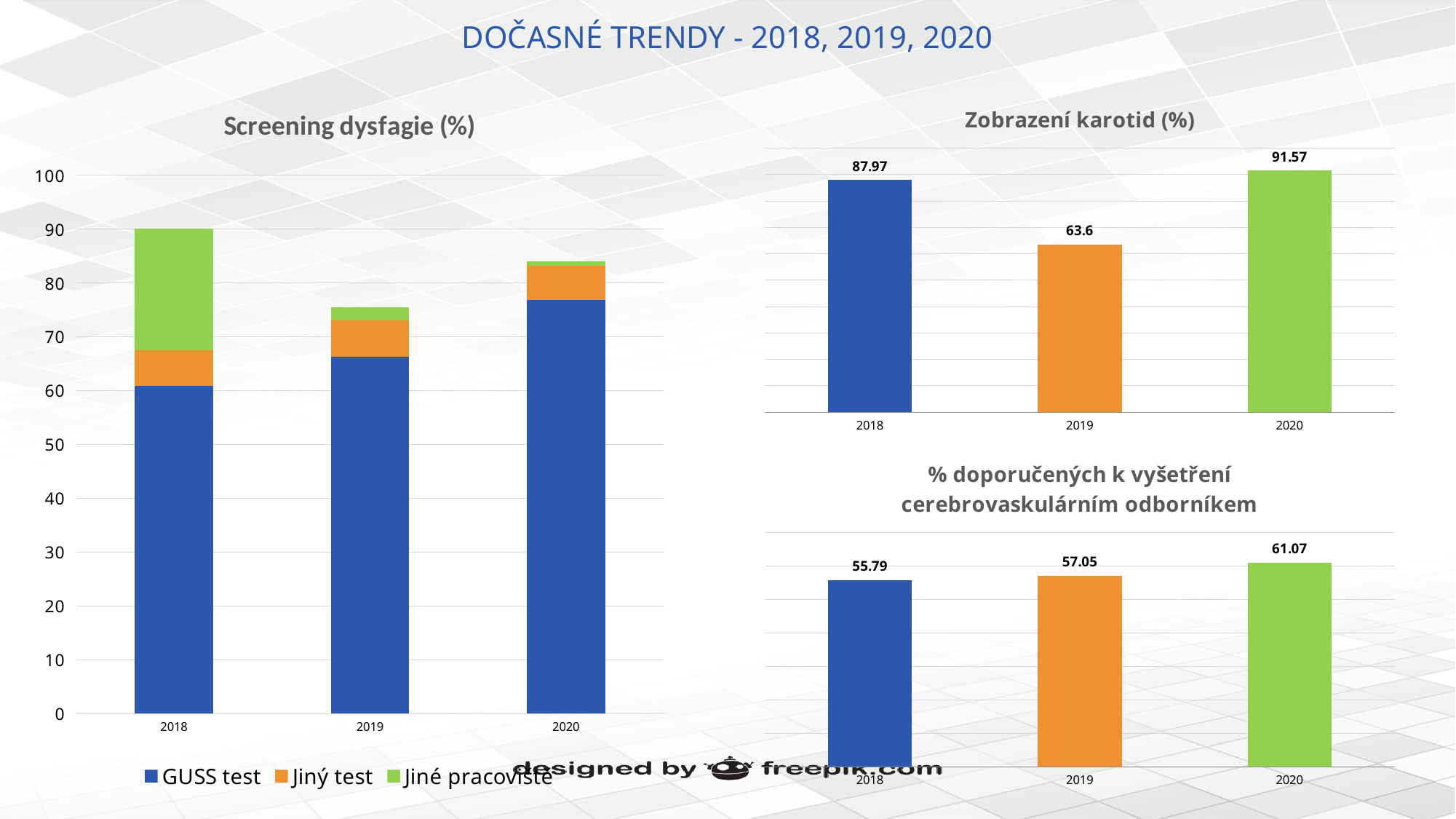
In the 'Zobrazení karotid (%)' chart, which year has the highest value? 2020 In the 'Screening dysfagie (%)' chart, how many series does the legend list? 3 In the 'Screening dysfagie (%)' chart, is the GUSS test value for 2018 greater or less than 70? less In the '% doporučených k vyšetření cerebrovaskulárním odborníkem' chart, what is the value for 2018? 55.79 In the '% doporučených k vyšetření cerebrovaskulárním odborníkem' chart, what is the difference between the 2019 and 2018 values? 1.26 In the 'Zobrazení karotid (%)' chart, what is the value for 2019? 63.6 What kind of chart is 'Screening dysfagie (%)'? stacked bar chart In the '% doporučených k vyšetření cerebrovaskulárním odborníkem' chart, do the values rise or fall from 2018 to 2020? rise In the 'Zobrazení karotid (%)' chart, which year has the lowest value? 2019 In the 'Zobrazení karotid (%)' chart, what is the difference between the 2020 and 2018 values? 3.6 In the '% doporučených k vyšetření cerebrovaskulárním odborníkem' chart, what is the value for 2020? 61.07 In the 'Screening dysfagie (%)' chart, is the GUSS test value for 2020 greater or less than 70? greater